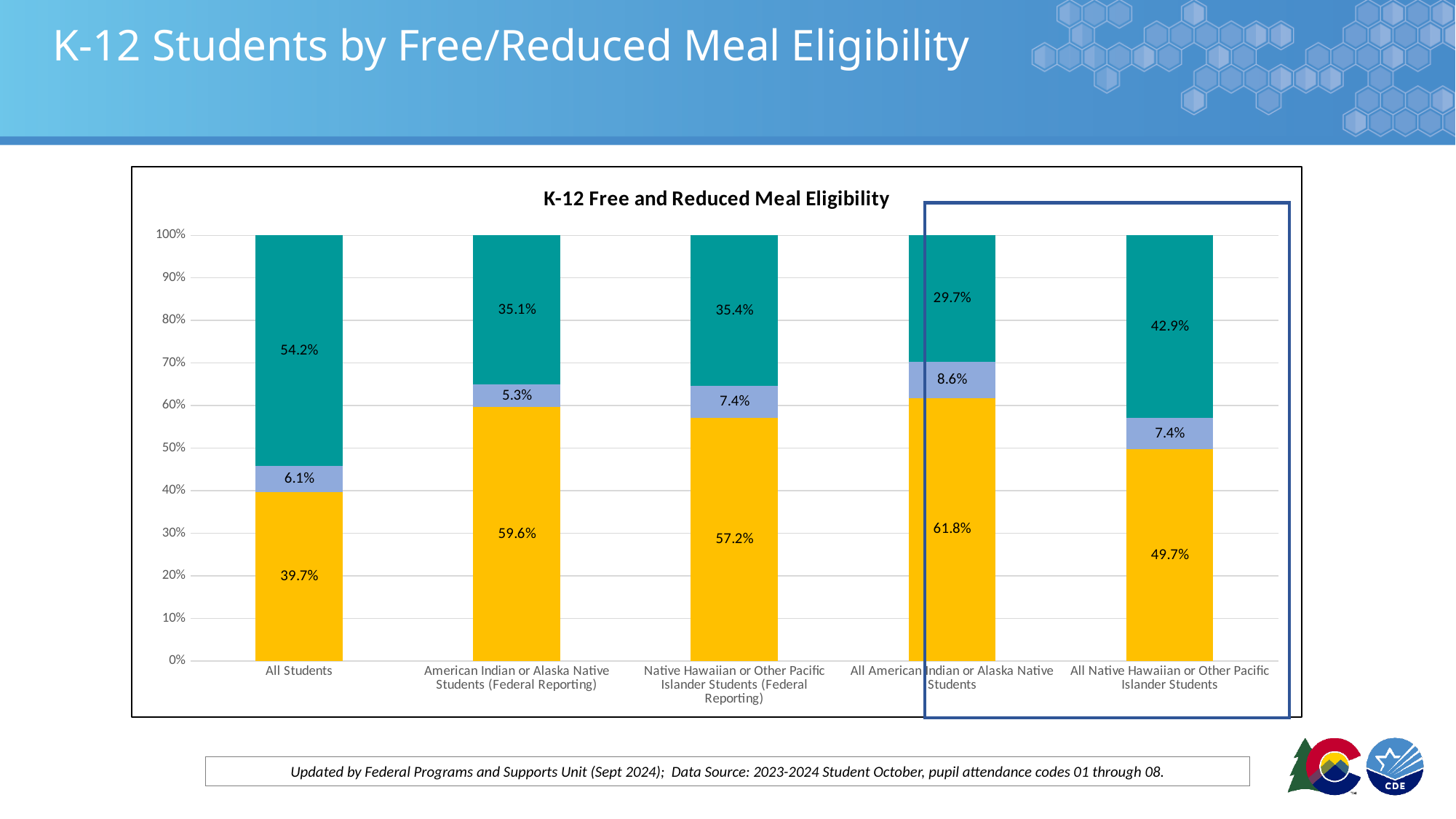
How many categories are shown along the x axis of the chart? 5 What is the title of the chart? K-12 Free and Reduced Meal Eligibility Which category has the highest value for the bottom (yellow) segment? All American Indian or Alaska Native Students What is the value of the bottom (yellow) segment for All Students? 39.7% What is the value of the bottom (yellow) segment for All Native Hawaiian or Other Pacific Islander Students? 49.7% What is the value of the middle (light blue) segment for All American Indian or Alaska Native Students? 8.6% Which is larger: the top (teal) segment for All Native Hawaiian or Other Pacific Islander Students or for All American Indian or Alaska Native Students? All Native Hawaiian or Other Pacific Islander Students What is the difference between the bottom (yellow) segment values for American Indian or Alaska Native Students (Federal Reporting) and Native Hawaiian or Other Pacific Islander Students (Federal Reporting)? 2.4% What is the total of the three segments for All American Indian or Alaska Native Students? 100.1% What kind of chart is shown on the slide? Stacked bar chart Which category has the lowest value for the top (teal) segment? All American Indian or Alaska Native Students What is the value of the top (teal) segment for All Students? 54.2%